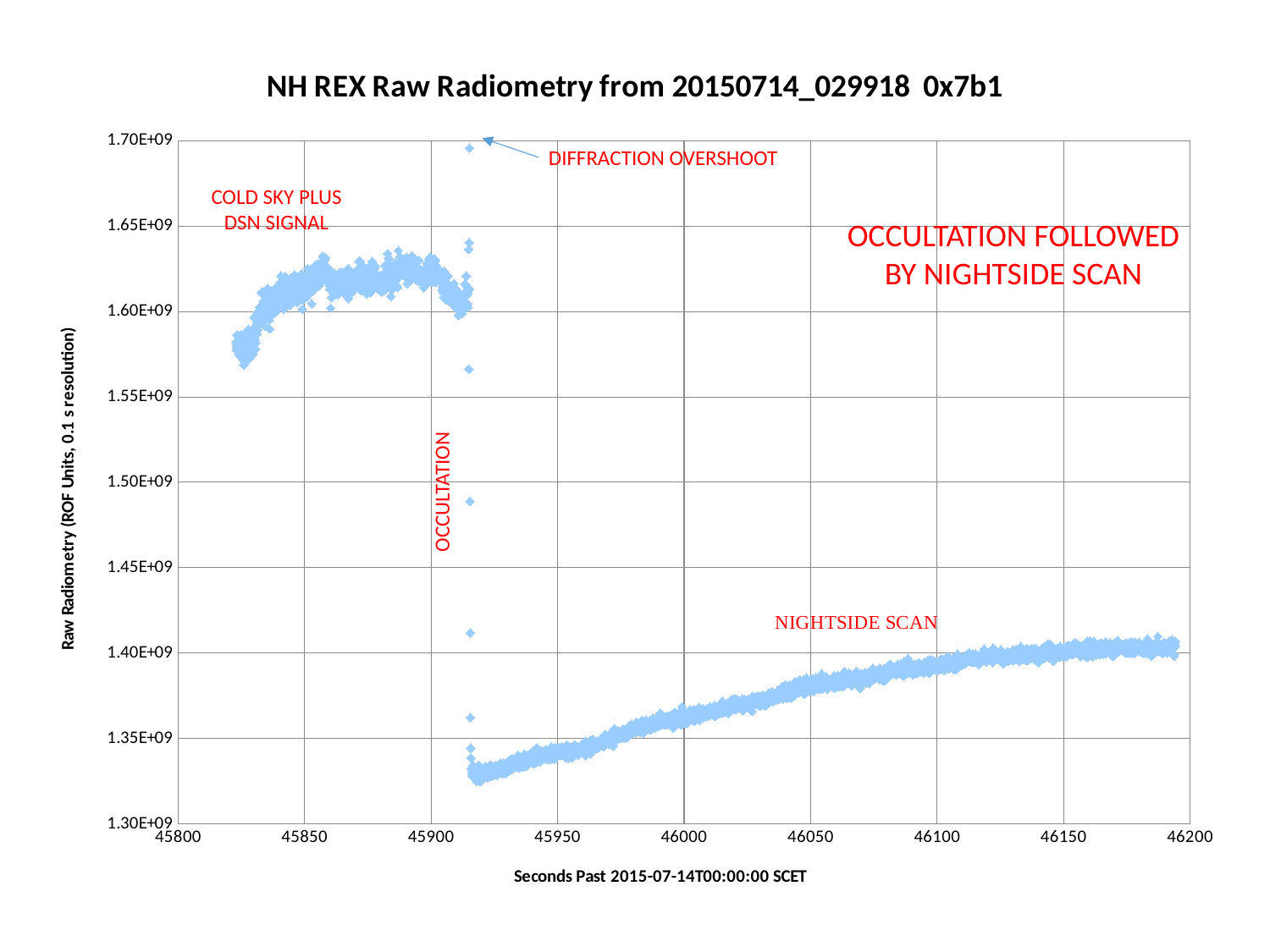
Is the highest point on the chart (the diffraction overshoot) greater or less than 1.65E+09? greater Is the value at about 46150 seconds greater or less than 1.45E+09? less Is the lowest point on the chart, near 45920 seconds, greater or less than 1.35E+09? less Which annotation labels the highest point on the chart, near 45915 seconds? DIFFRACTION OVERSHOOT Do the values rise or fall between about 45825 and 45850 seconds in the cold sky plus DSN signal segment? rise What kind of chart is shown on the slide? scatter chart Which segment has higher values: the cold sky plus DSN signal segment or the nightside scan segment? cold sky plus DSN signal Do the values in the nightside scan segment (from about 45920 to 46200 seconds) rise or fall as the x axis increases? rise What is the title of the chart? NH REX Raw Radiometry from 20150714_029918 0x7b1